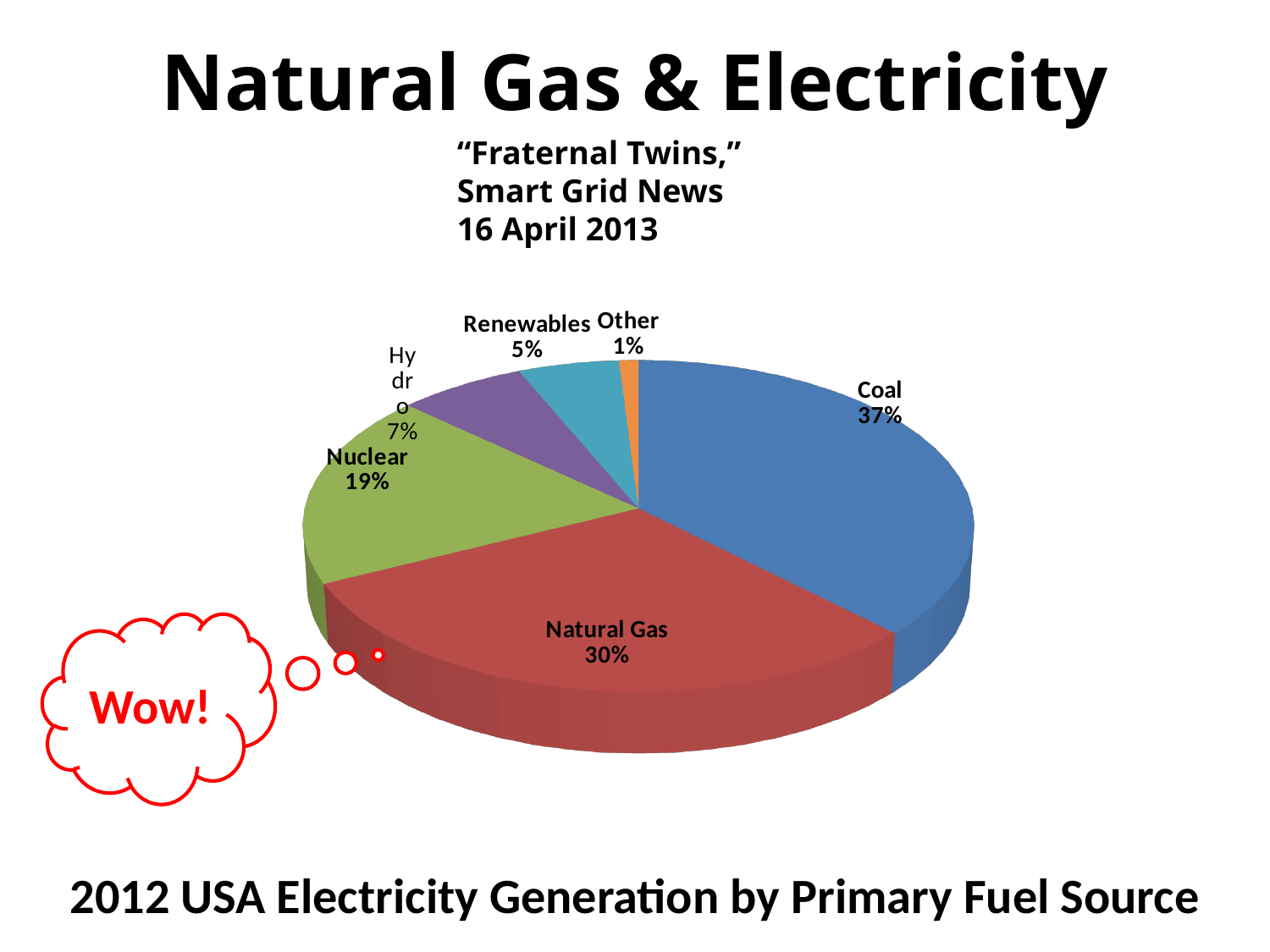
Which fuel source has the smallest share of the pie? Other What share of 2012 USA electricity generation came from Coal? 37% How many slices does the pie chart have? 6 Which fuel source has the largest share of the pie? Coal Which has a larger share, Nuclear or Hydro? Nuclear What share of 2012 USA electricity generation came from Natural Gas? 30% What kind of chart is shown on the slide? Pie chart What share of 2012 USA electricity generation came from Hydro? 7% What share of 2012 USA electricity generation came from Renewables? 5% What is the caption below the chart? 2012 USA Electricity Generation by Primary Fuel Source What share of 2012 USA electricity generation came from Nuclear? 19% How many percentage points larger is Coal's share than Natural Gas's share? 7